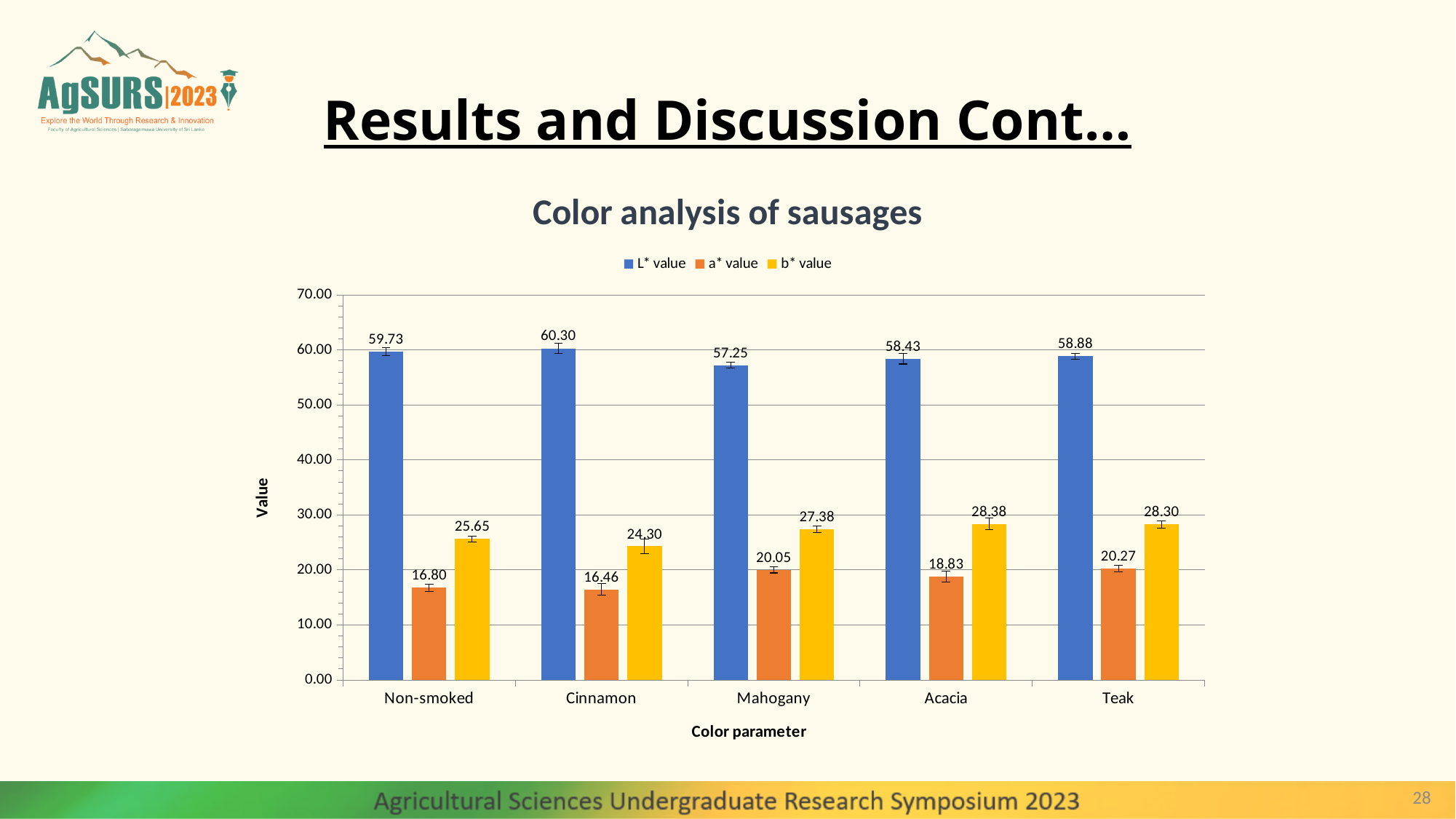
How many series does the legend list? 3 Which category has the highest L* value? Cinnamon What is the title of the chart? Color analysis of sausages What is the b* value for Acacia? 28.38 Which category has the lowest b* value? Cinnamon What is the difference between the L* value for Non-smoked and the L* value for Mahogany? 2.48 What is the a* value for Mahogany? 20.05 What is the L* value for Cinnamon? 60.30 How many categories are shown on the x axis? 5 Which category has the lowest a* value? Cinnamon Which is larger, the b* value for Teak or the b* value for Mahogany? Teak What kind of chart is shown on the slide? Bar chart